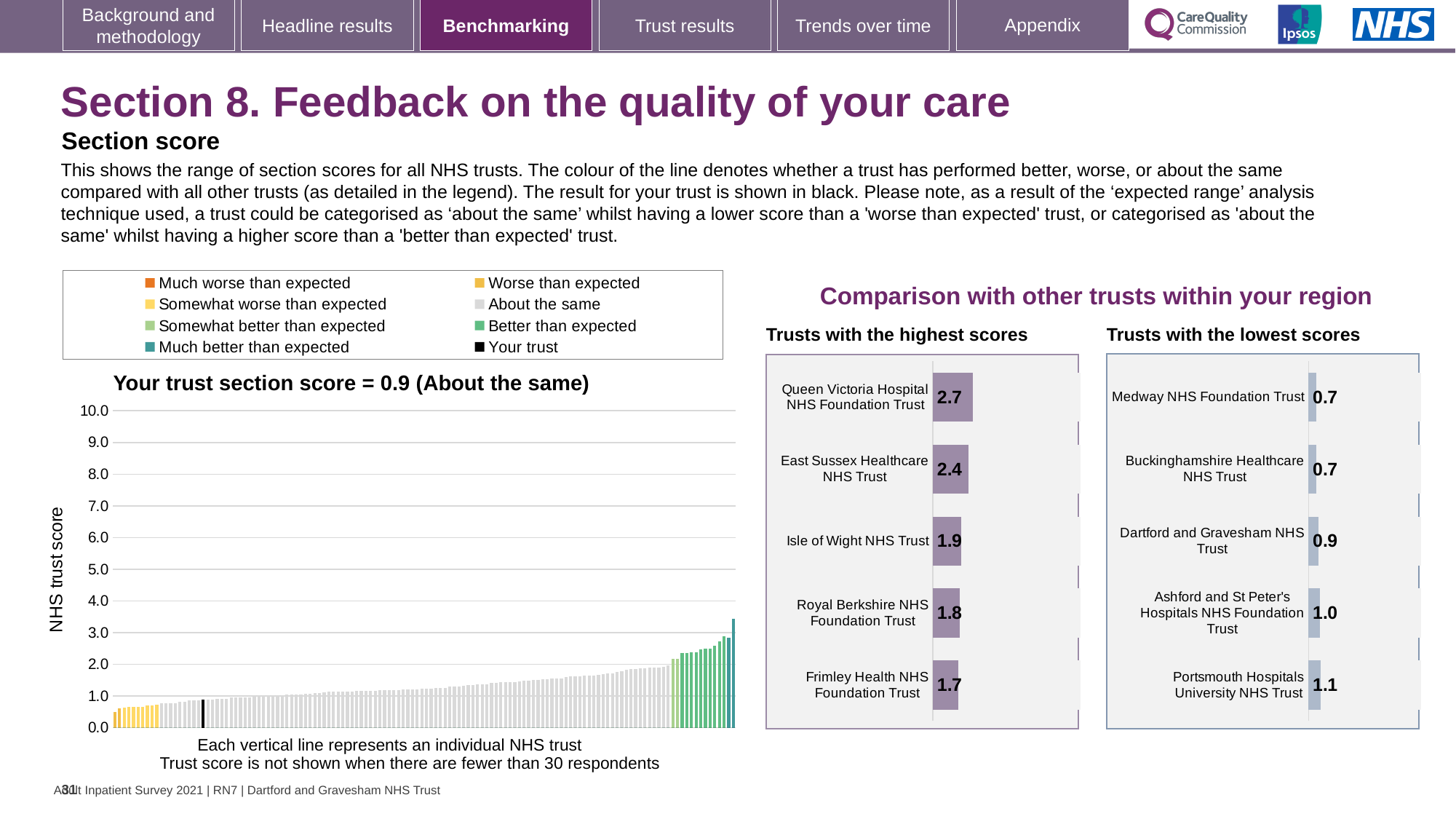
In the main chart on the left, do the trust scores rise or fall from left to right? Rise In the 'Trusts with the lowest scores' chart, which trust has the highest score shown? Portsmouth Hospitals University NHS Trust In the 'Trusts with the lowest scores' chart, how many trusts are listed? 5 In the 'Trusts with the lowest scores' chart, what is the score for Portsmouth Hospitals University NHS Trust? 1.1 In the 'Trusts with the highest scores' chart, what is the score for Queen Victoria Hospital NHS Foundation Trust? 2.7 In the 'Trusts with the highest scores' chart, what is the score for Frimley Health NHS Foundation Trust? 1.7 In the 'Trusts with the highest scores' chart, which has the larger score: Isle of Wight NHS Trust or Royal Berkshire NHS Foundation Trust? Isle of Wight NHS Trust In the 'Trusts with the lowest scores' chart, what is the score for Dartford and Gravesham NHS Trust? 0.9 In the 'Trusts with the highest scores' chart, which trust has the highest score? Queen Victoria Hospital NHS Foundation Trust In the 'Trusts with the highest scores' chart, what is the difference between the scores of Queen Victoria Hospital NHS Foundation Trust and East Sussex Healthcare NHS Trust? 0.3 What kind of chart is the main chart on the left showing NHS trust scores? Bar chart According to the title of the main chart on the left, what is your trust's section score? 0.9